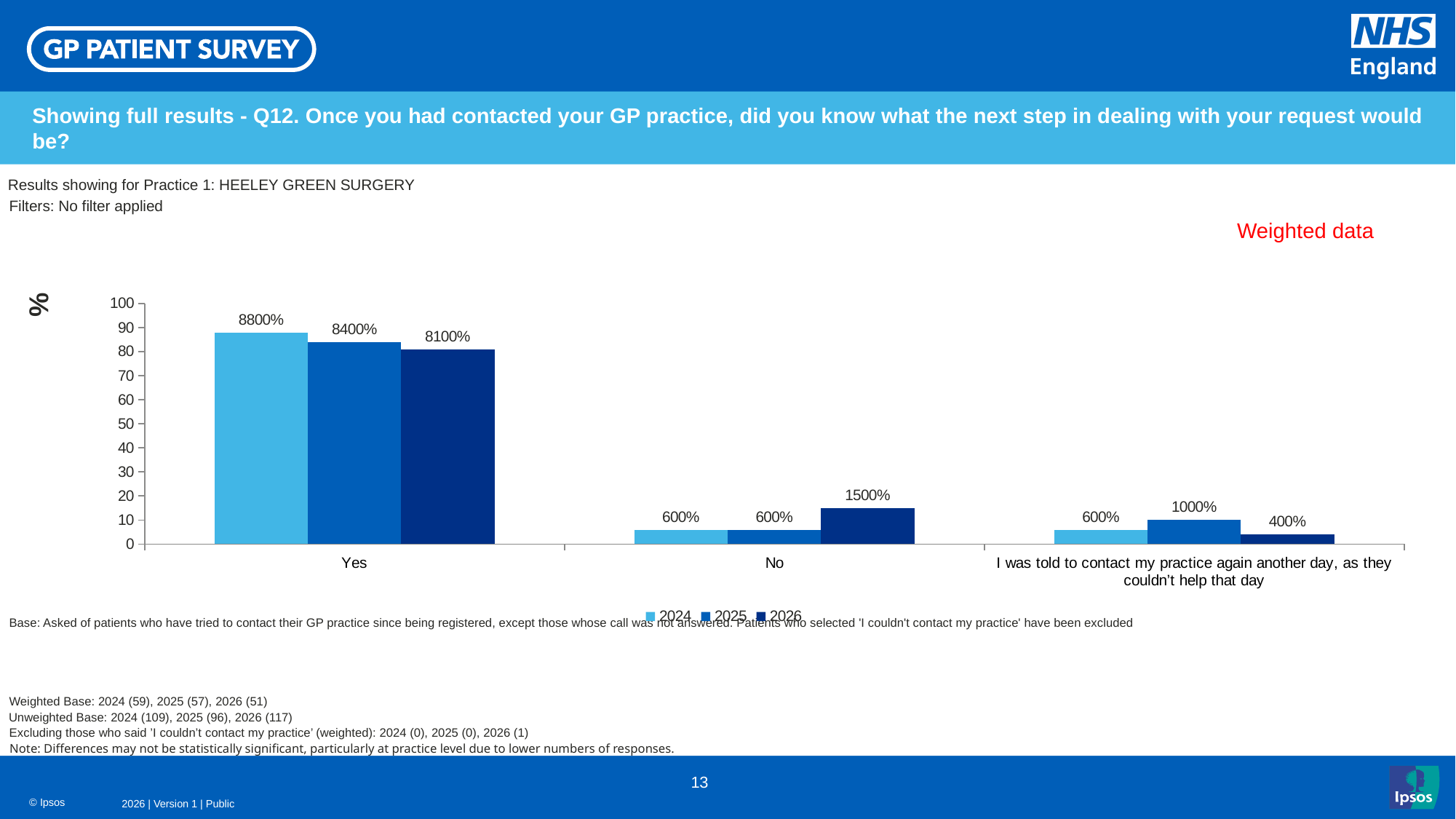
How many series does the legend list? 3 What is the data label for 2025 in the 'I was told to contact my practice again another day, as they couldn't help that day' category? 1000% Which is larger in the 'No' category: the 2025 value or the 2026 value? 2026 Which category has the highest value for 2025? Yes Do the values for the 'Yes' category rise or fall from 2024 to 2026? fall What kind of chart is shown on the slide? bar chart Which category has the lowest value for 2026? I was told to contact my practice again another day, as they couldn't help that day What is the data label for 2026 in the 'Yes' category? 8100% What are the three legend entries? 2024, 2025, 2026 What is the data label for 2026 in the 'No' category? 1500% What is the data label for 2024 in the 'Yes' category? 8800% How many categories are shown on the x axis? 3